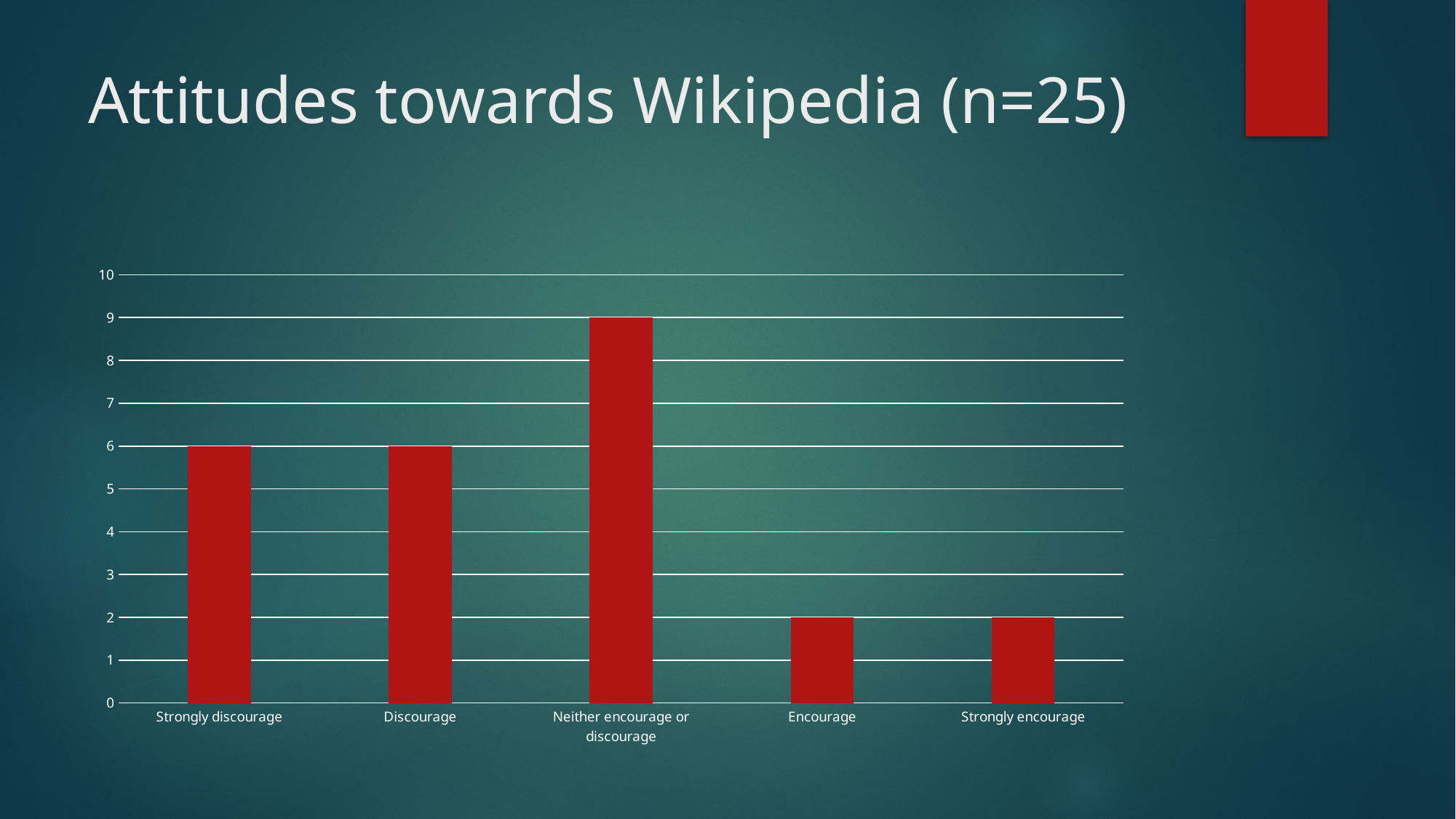
What is the value for "Encourage"? 2 How many categories are shown on the x axis? 5 Which is larger, the value for "Discourage" or the value for "Strongly encourage"? Discourage What kind of chart is shown on the slide? bar chart Which category has the highest value? Neither encourage or discourage What is the value for "Neither encourage or discourage"? 9 What is the title of the slide? Attitudes towards Wikipedia (n=25) What is the difference between the values for "Neither encourage or discourage" and "Discourage"? 3 Is the value for "Neither encourage or discourage" greater or less than 5? greater What colour are the bars in the chart? red What is the value for "Strongly discourage"? 6 What is the difference between the values for "Strongly discourage" and "Encourage"? 4